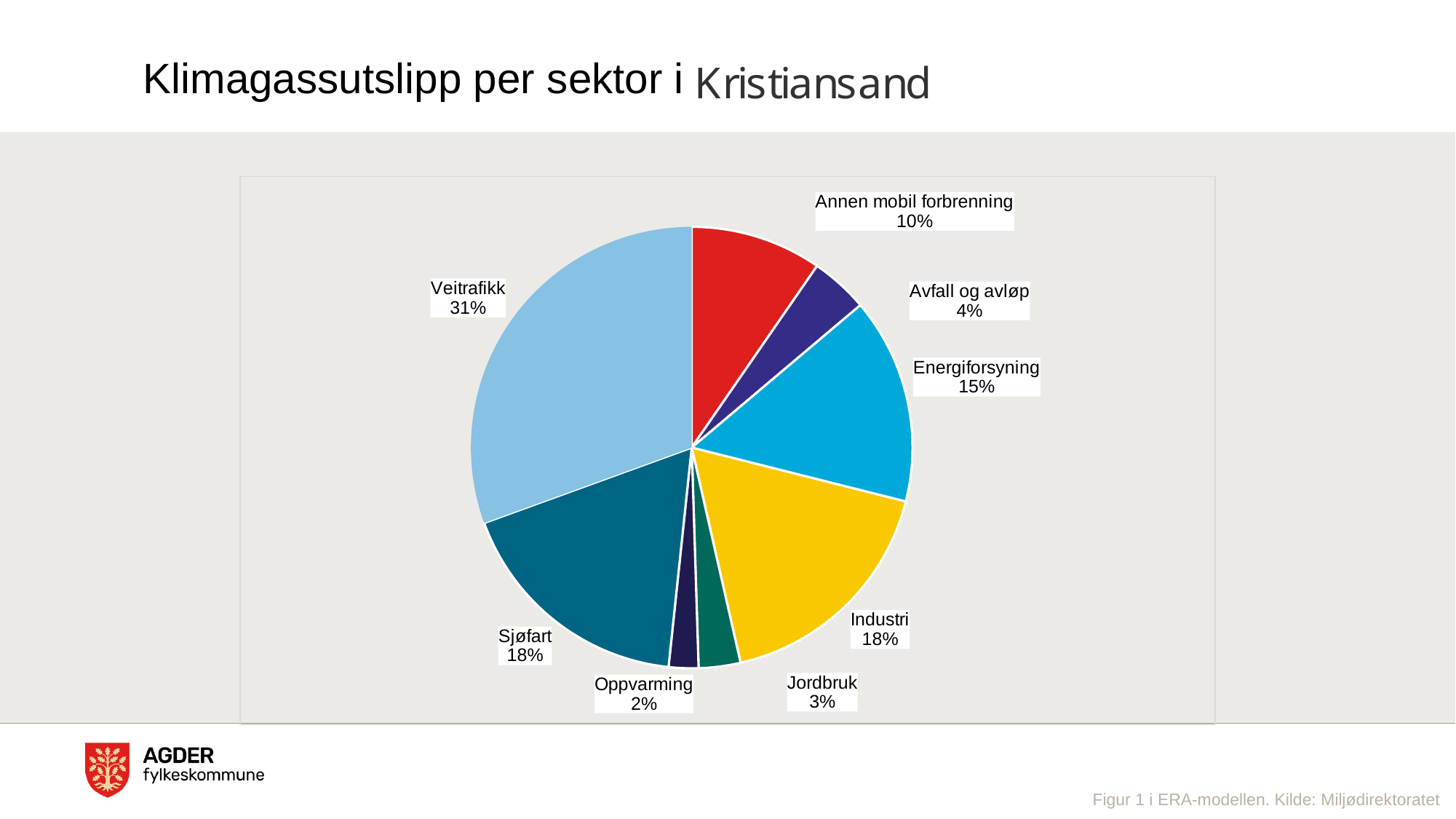
What share of emissions does Veitrafikk account for? 31% What is the title of the slide? Klimagassutslipp per sektor i Kristiansand What percentage is shown for Avfall og avløp? 4% What is the difference in percentage points between Veitrafikk and Sjøfart? 13 What kind of chart is shown on the slide? Pie chart Which sector has the smallest share of the pie? Oppvarming Which sector has the largest share of the pie? Veitrafikk How many sectors are shown in the pie chart? 8 What percentage is shown for Energiforsyning? 15% What is the value for Annen mobil forbrenning? 10% Which is larger, Energiforsyning or Annen mobil forbrenning? Energiforsyning What is the combined share of Industri and Jordbruk? 21%